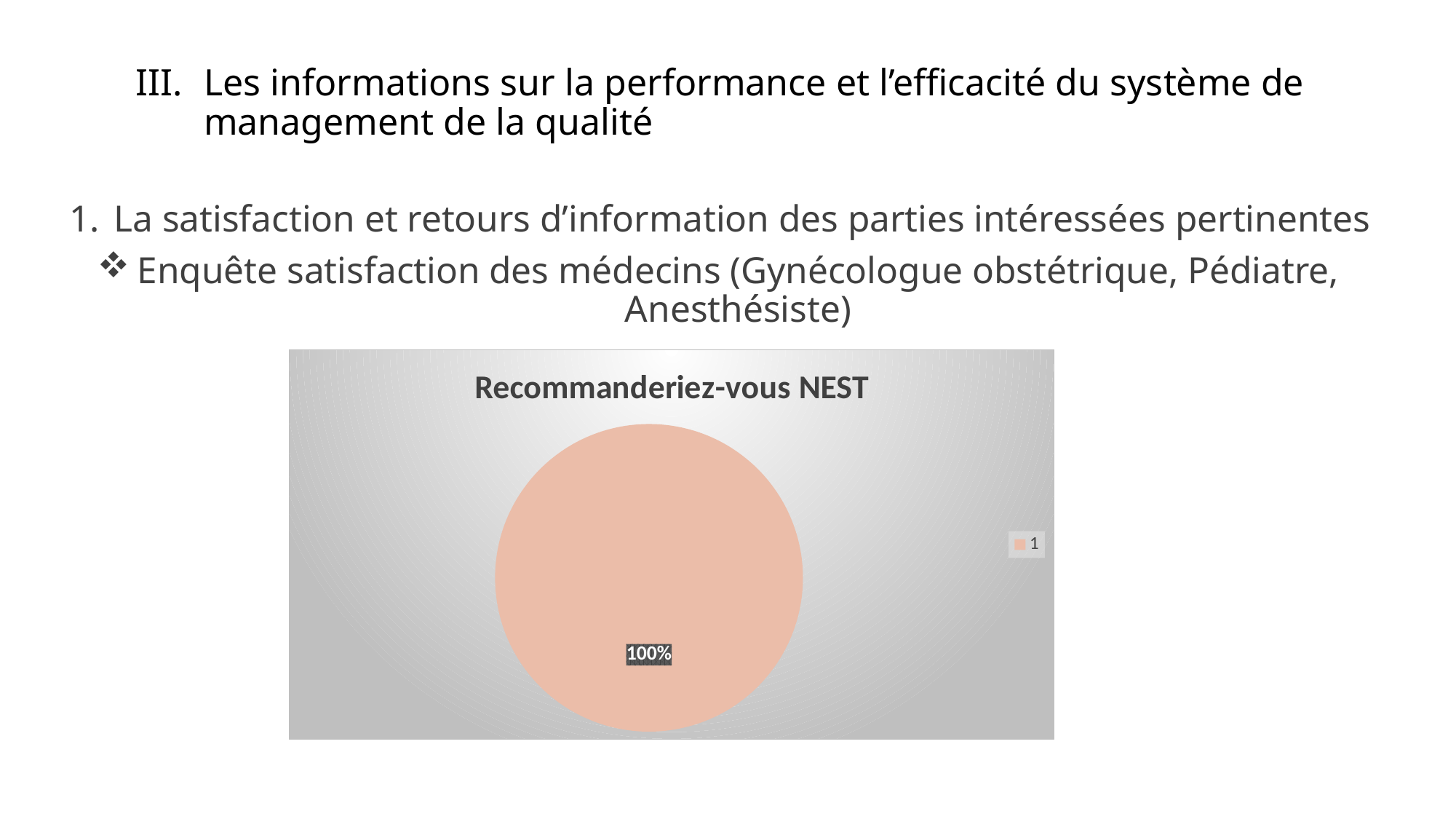
How many entries does the legend list? 1 How many slices does the pie chart have? 1 What is the label of the legend entry? 1 What percentage is shown on the data label of the pie slice? 100% What kind of chart is shown on the slide? pie chart What is the title of the chart? Recommanderiez-vous NEST What share of the pie does the slice labelled 1 represent? 100%